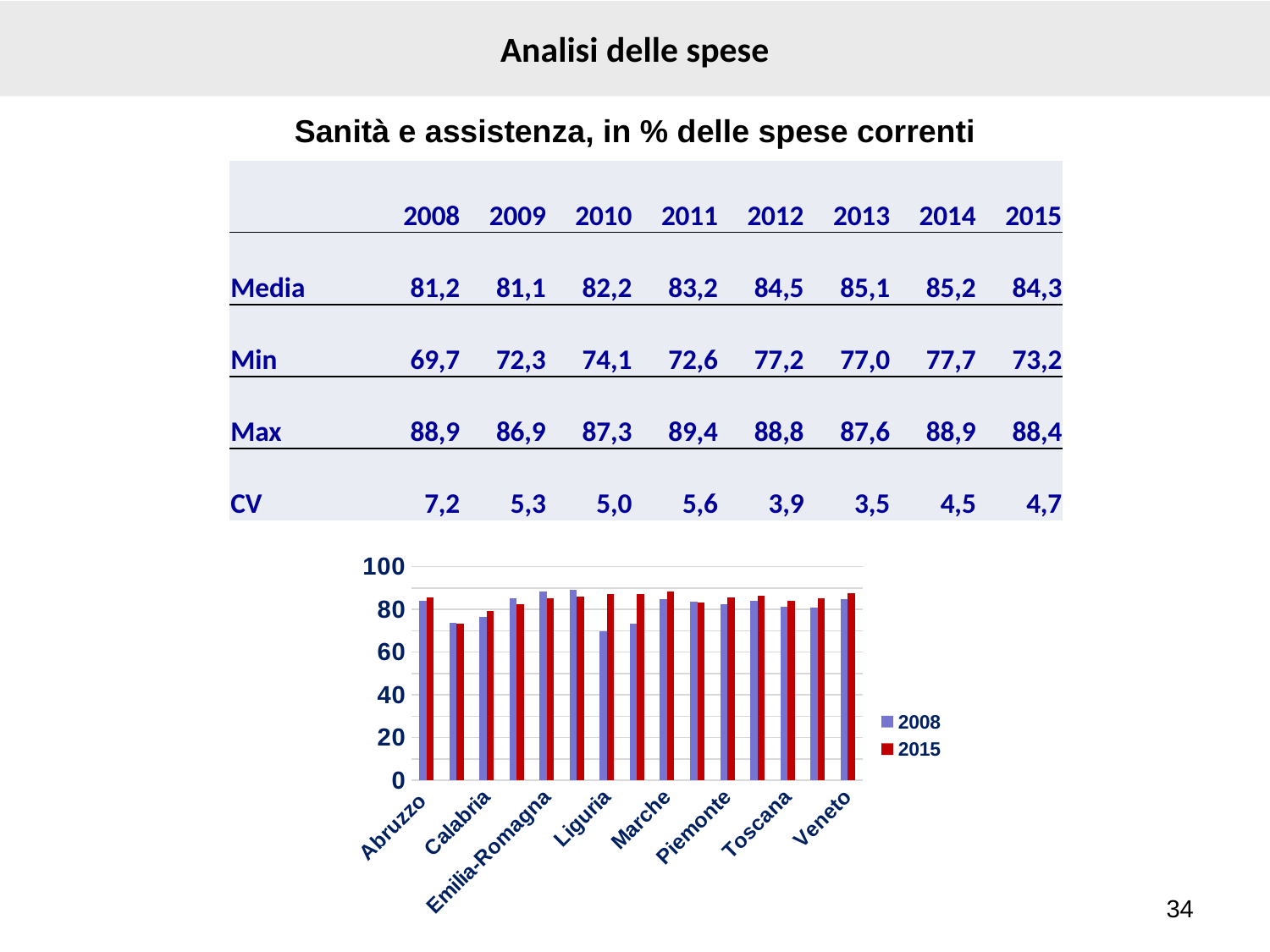
In the bar chart, which colour represents the 2015 series? red How many series does the legend of the bar chart list? 2 In the bar chart, which is larger for Marche: the 2008 value or the 2015 value? 2015 In the bar chart, is the 2015 value for Liguria greater or less than 80? greater Which years are listed in the legend of the bar chart? 2008 and 2015 In the bar chart, is the 2008 value for Emilia-Romagna greater or less than 80? greater In the bar chart, is the 2008 value for Calabria greater or less than 80? less What kind of chart is shown on the slide? bar chart How many regions are shown on the x axis of the bar chart? 8 In the bar chart, which is larger for Liguria: the 2008 value or the 2015 value? 2015 In the bar chart, which region has the lowest 2008 value? Liguria